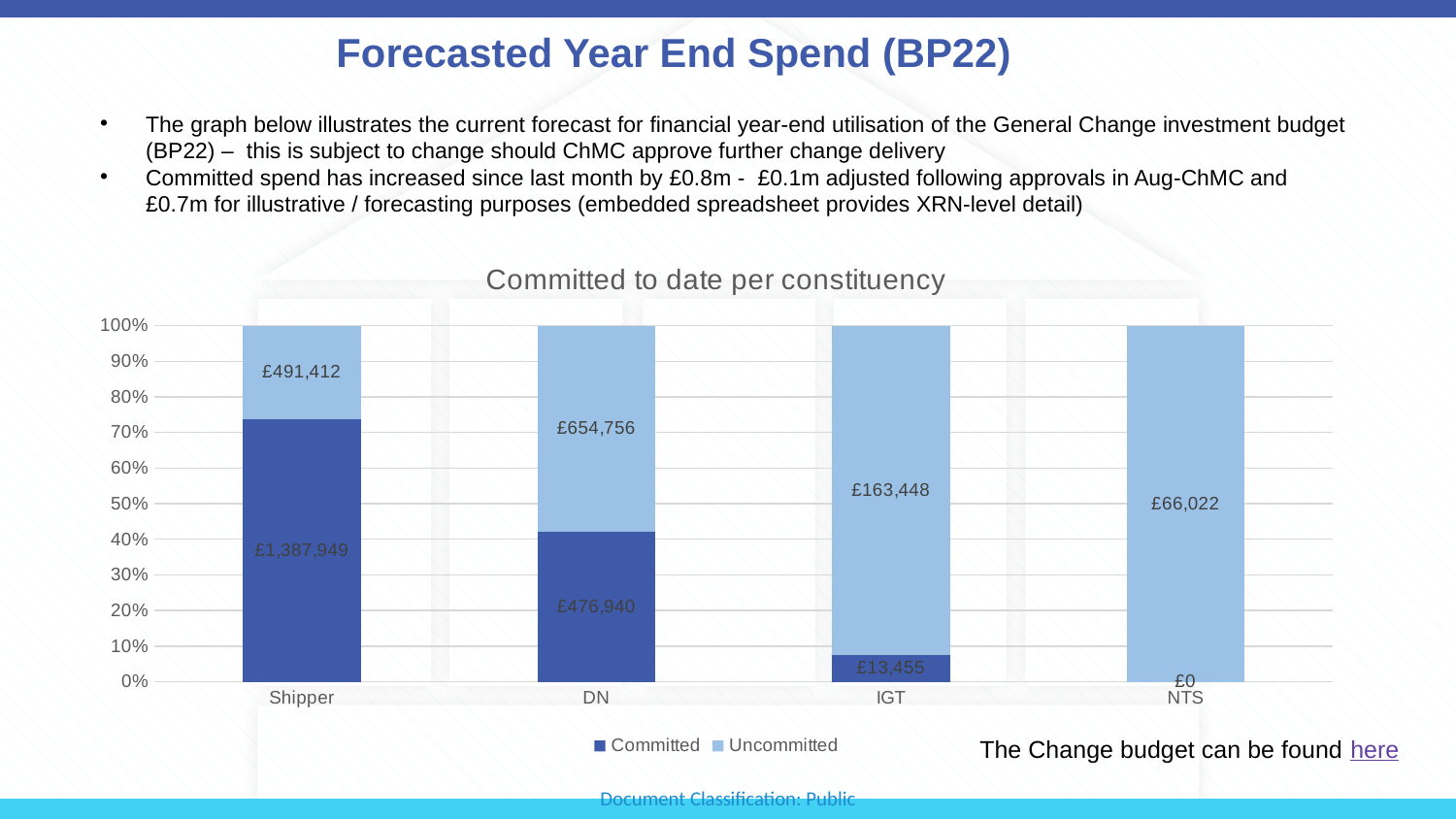
What is the Committed value for NTS? £0 What kind of chart is shown? Stacked bar chart Which constituency has the lowest Uncommitted value? NTS What is the Committed value for IGT? £13,455 Which constituency has the highest Committed value? Shipper What is the total of the Committed and Uncommitted values for Shipper? £1,879,361 What is the Committed value for Shipper? £1,387,949 How many constituencies are shown on the x axis? 4 Which is larger for IGT, the Committed value or the Uncommitted value? Uncommitted What is the difference between the Committed and Uncommitted values for DN? £177,816 What is the Uncommitted value for DN? £654,756 How many series does the legend list? 2